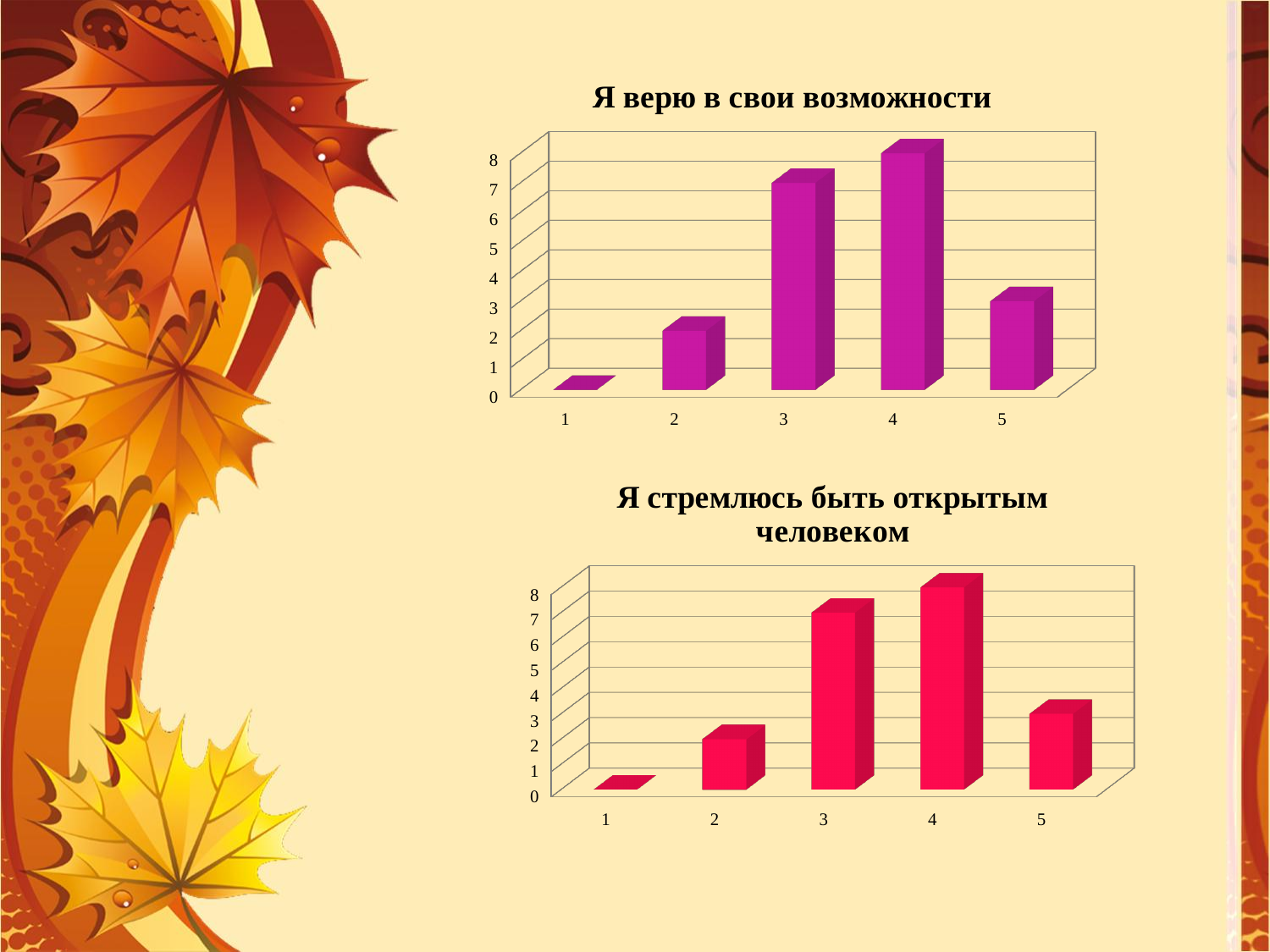
How many categories are shown on the x axis of the chart titled "Я стремлюсь быть открытым человеком"? 5 In the chart titled "Я верю в свои возможности", which is larger, the value for category 5 or the value for category 2? category 5 In the chart titled "Я стремлюсь быть открытым человеком", is the value for category 5 greater or less than 6? less How many categories are shown on the x axis of the chart titled "Я верю в свои возможности"? 5 In the chart titled "Я верю в свои возможности", which category has the highest bar? 4 In the chart titled "Я верю в свои возможности", which category has the lowest bar? 1 What kind of chart is the chart titled "Я стремлюсь быть открытым человеком"? bar chart In the chart titled "Я стремлюсь быть открытым человеком", which is larger, the value for category 3 or the value for category 5? category 3 In the chart titled "Я стремлюсь быть открытым человеком", which category has the highest bar? 4 In the chart titled "Я верю в свои возможности", is the value for category 2 greater or less than 4? less What kind of chart is the chart titled "Я верю в свои возможности"? bar chart In the chart titled "Я верю в свои возможности", is the value for category 3 greater or less than 5? greater